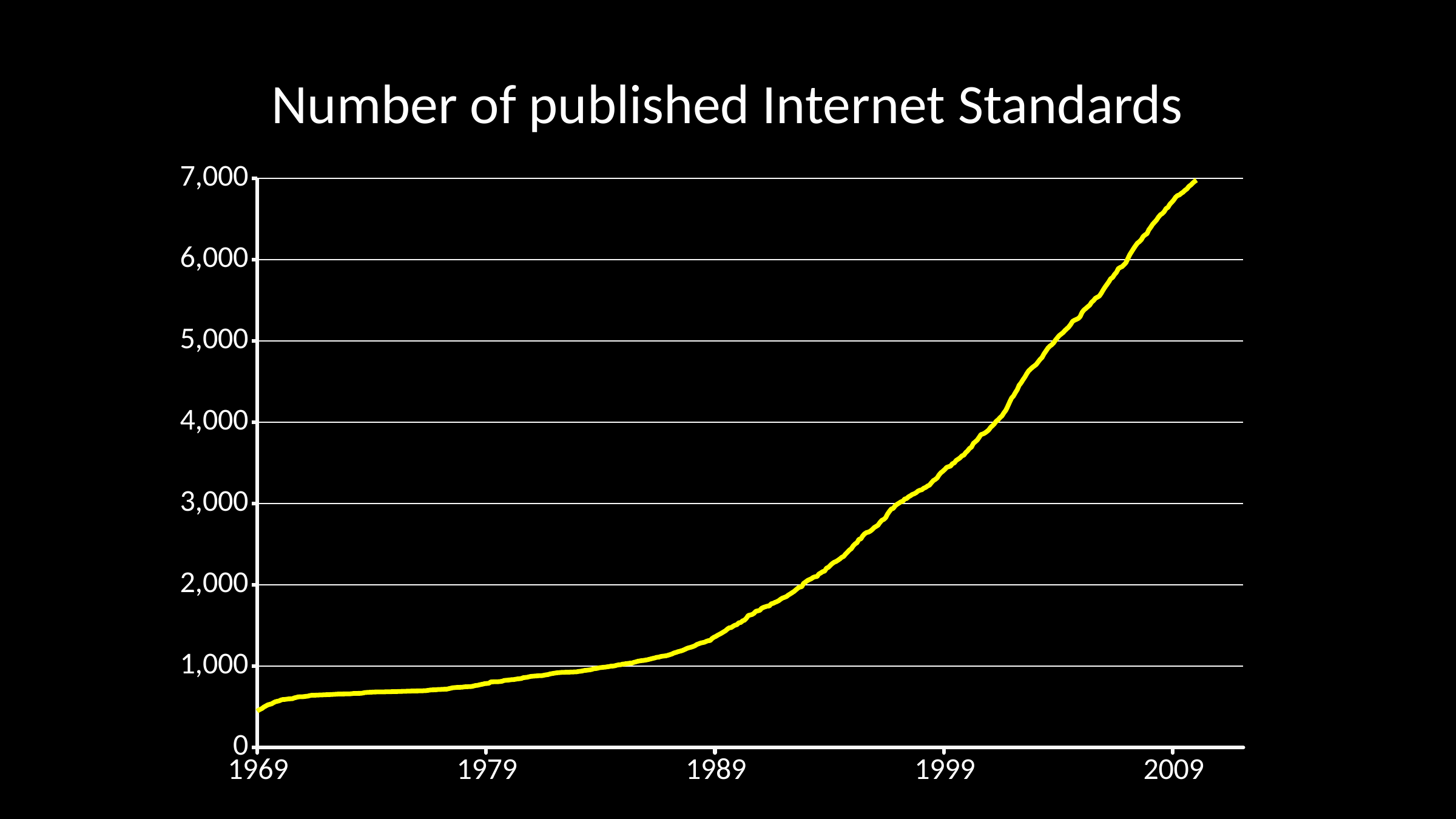
Which year has the higher value, 1979 or 1999? 1999 Is the value for 1989 greater or less than 2,000? less Is the value for 1999 greater or less than 2,000? greater Is the value for 1989 greater or less than 1,000? greater What is the first year labelled on the horizontal axis? 1969 What is the title of the chart? Number of published Internet Standards What is the highest value shown on the vertical axis? 7,000 What kind of chart is shown on the slide? line chart Do the values rise or fall from 1969 to 2009? rise